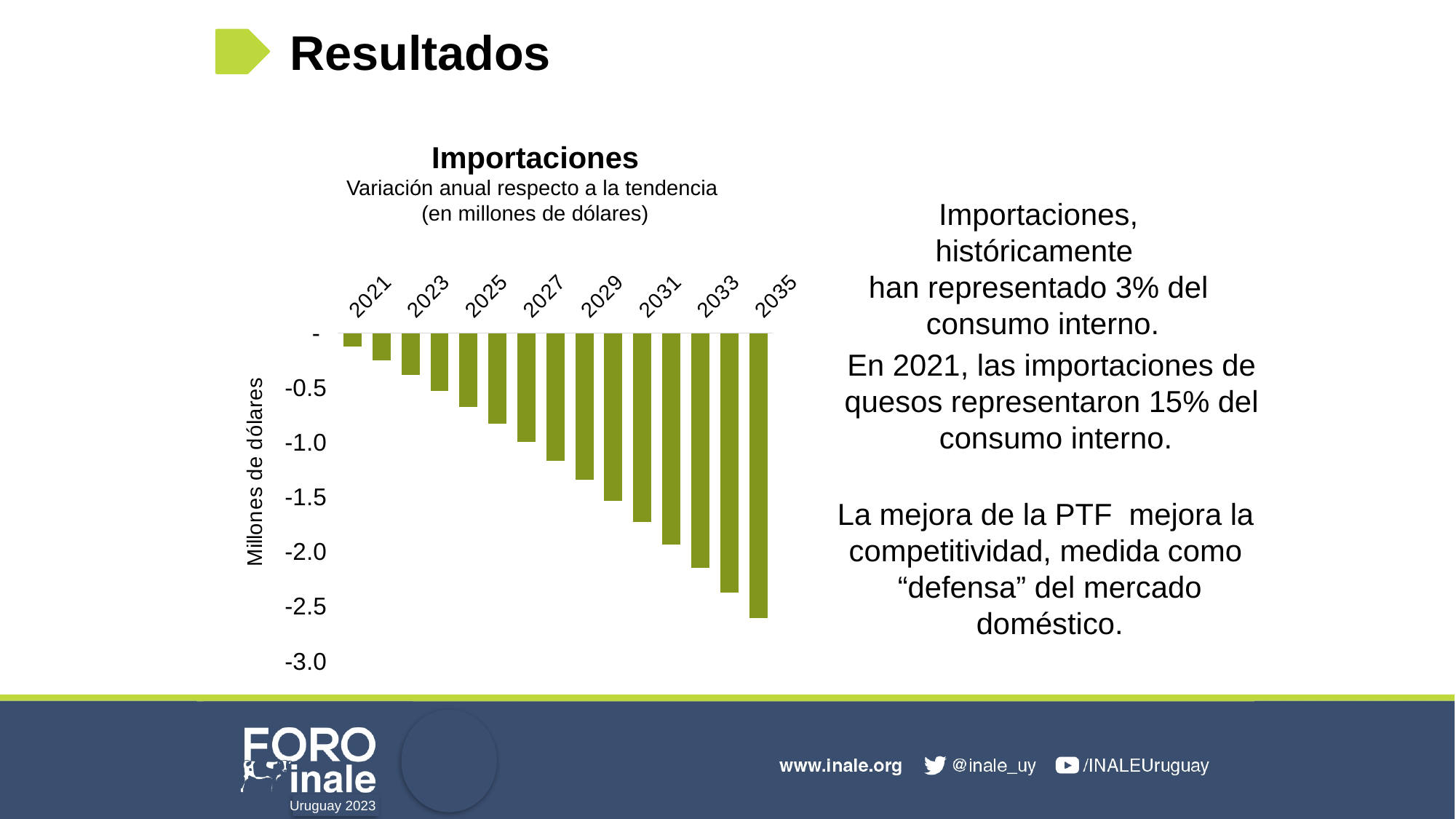
What is the label on the vertical axis of the chart? Millones de dólares Is the value for 2035 greater or less than -2.0? less Which year has the highest value (closest to zero) in the chart? 2021 Do the values rise or fall as the years go from 2021 to 2035? Fall Is the value for 2031 greater or less than -1.5? less What is the title of the chart? Importaciones What kind of chart is shown on the slide? Bar chart Is the value for 2027 greater or less than -0.5? less How many bars are plotted in the chart? 15 Which year has the larger value, 2023 or 2029? 2023 Which year has the lowest (most negative) value in the chart? 2035